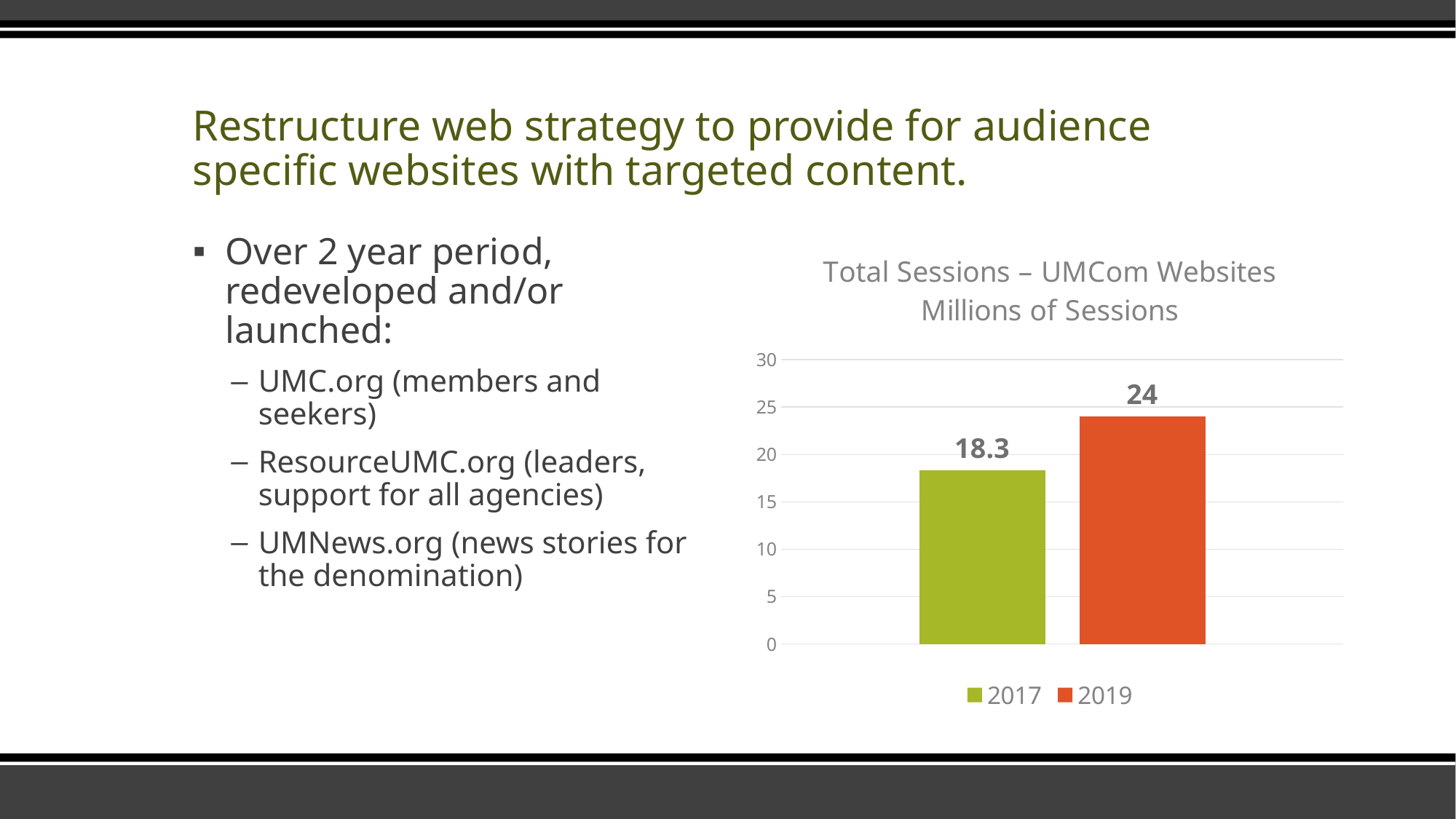
Is the value for 2017 greater or less than 20? less Is the value for 2019 greater or less than 20? greater Do the values rise or fall from 2017 to 2019? Rise What is the value for 2017 in the Total Sessions – UMCom Websites chart? 18.3 What kind of chart is shown on the slide? Bar chart What is the value for 2019 in the Total Sessions – UMCom Websites chart? 24 What is the title of the chart on the slide? Total Sessions – UMCom Websites Millions of Sessions Which year has the lower value in the chart? 2017 Is the value for 2019 larger than the value for 2017? Yes What is the difference between the 2019 and 2017 values in the chart? 5.7 Which year has the higher value in the chart? 2019 How many series does the chart legend list? 2